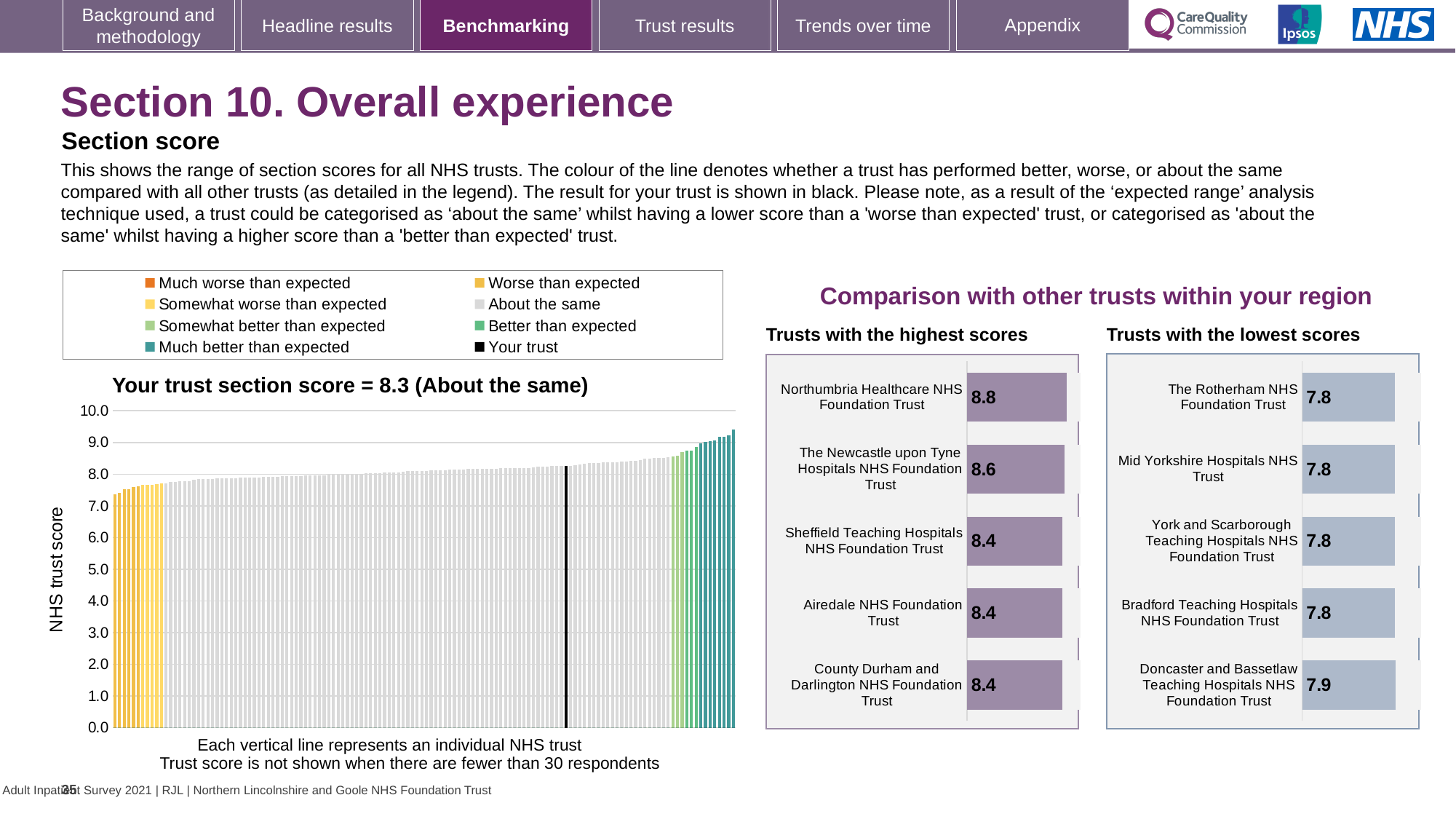
How many trusts are shown on the 'Trusts with the lowest scores' chart? 5 On the 'Your trust section score' chart, what is the label on the vertical axis? NHS trust score On the 'Your trust section score' chart, is the value of the rightmost bar greater or less than 9.0? greater On the 'Trusts with the highest scores' chart, what is the difference between the scores of Northumbria Healthcare NHS Foundation Trust and The Newcastle upon Tyne Hospitals NHS Foundation Trust? 0.2 On the 'Your trust section score' chart, is the value of the leftmost bar greater or less than 8.0? less On the 'Your trust section score' chart, what is the section score for your trust? 8.3 On the 'Trusts with the lowest scores' chart, which trust has the highest score? Doncaster and Bassetlaw Teaching Hospitals NHS Foundation Trust On the 'Your trust section score' chart, do the bars rise or fall from left to right? rise What kind of chart is the 'Your trust section score' chart? bar chart On the 'Trusts with the highest scores' chart, what is the score for The Newcastle upon Tyne Hospitals NHS Foundation Trust? 8.6 How many entries does the legend above the 'Your trust section score' chart list? 8 On the 'Trusts with the highest scores' chart, which trust has the highest score? Northumbria Healthcare NHS Foundation Trust